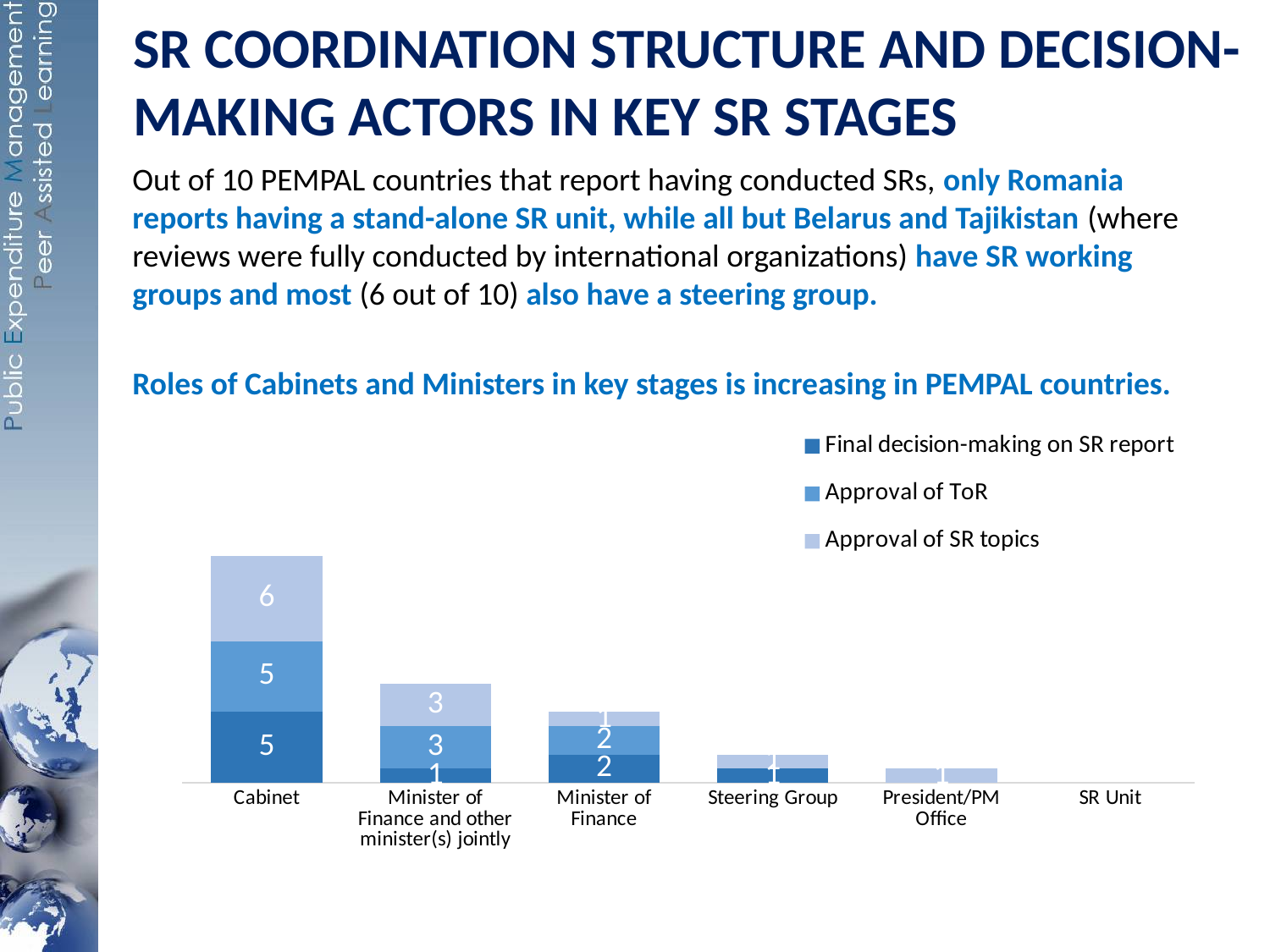
How many categories are shown along the x axis of the chart? 6 What is the difference between the 'Approval of SR topics' value for Cabinet and for Minister of Finance and other minister(s) jointly? 3 What is the total of the stacked bar for Cabinet? 16 What kind of chart is shown on the slide? Stacked bar chart Which category has the tallest stacked bar? Cabinet How many series does the chart legend list? 3 Which series is shown in the lightest blue in the legend? Approval of SR topics What is the value for 'Final decision-making on SR report' for Minister of Finance and other minister(s) jointly? 1 What is the total of the stacked bar for Minister of Finance and other minister(s) jointly? 7 What is the value for 'Approval of ToR' for Minister of Finance? 2 What is the value for 'Approval of ToR' for Cabinet? 5 What is the value for 'Approval of SR topics' for Cabinet? 6